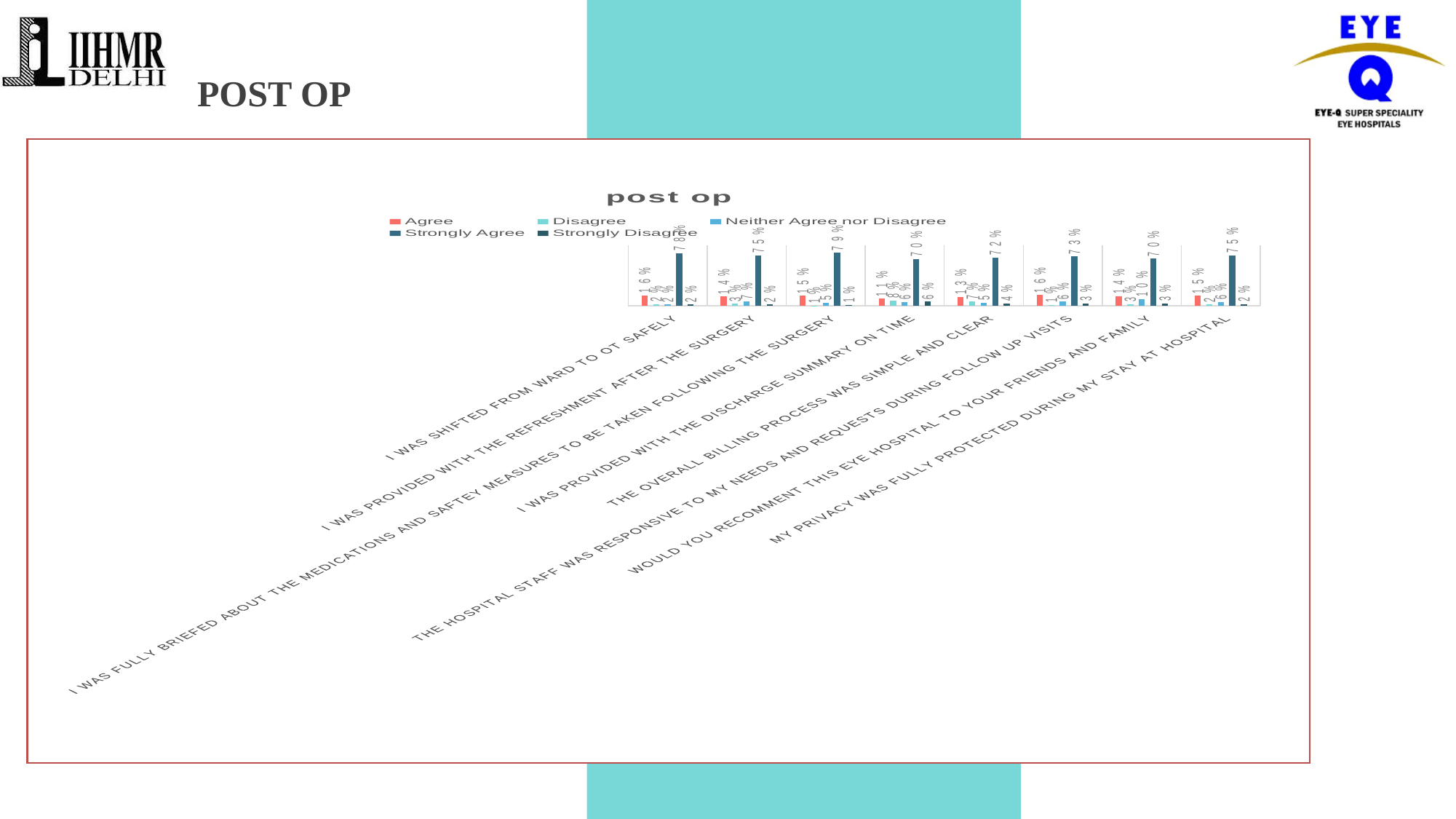
What is the difference between the Strongly Agree values for 'I was shifted from ward to OT safely' and 'I was provided with the refreshment after the surgery'? 3% What is the Strongly Agree value for 'I was shifted from ward to OT safely'? 78% Which statement has the highest Strongly Agree value? I was fully briefed about the medications and safety measures to be taken following the surgery What type of chart is shown on the slide? bar chart What is the Agree value for 'I was provided with the discharge summary on time'? 11% What is the title of the chart? post op What is the Strongly Agree value for 'My privacy was fully protected during my stay at hospital'? 75% Which statement has the lowest Agree value? I was provided with the discharge summary on time Which is larger: the Strongly Agree value for 'The overall billing process was simple and clear' or for 'Would you recommend this eye hospital to your friends and family'? The overall billing process was simple and clear What is the Strongly Agree value for 'I was fully briefed about the medications and safety measures to be taken following the surgery'? 79% How many categories (statements) are plotted in the 'post op' chart? 8 How many series does the legend of the 'post op' chart list? 5